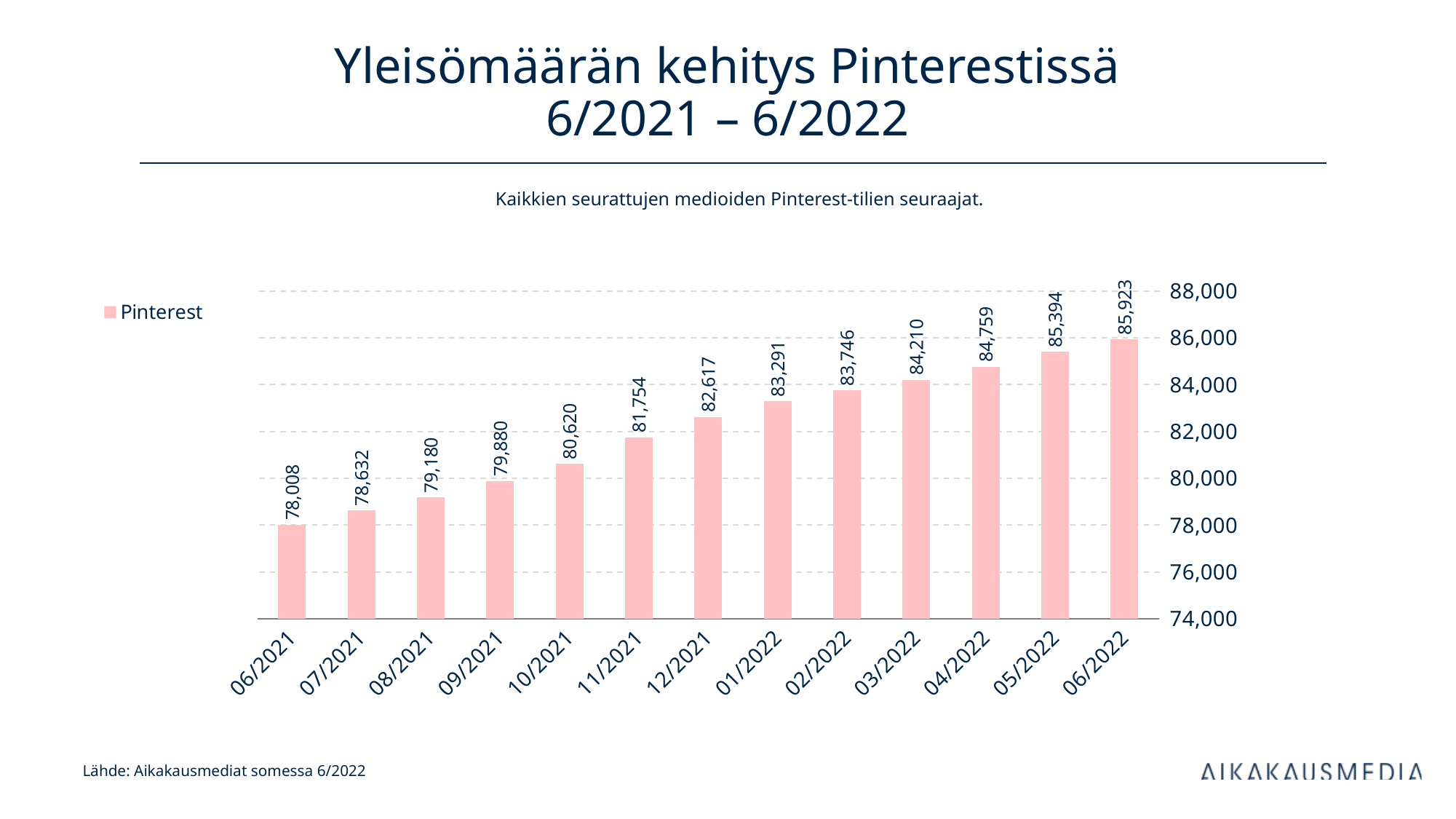
Do the values rise or fall from 06/2021 to 06/2022? rise What is the value for 03/2022? 84,210 How many series does the legend list? 1 Which month has the lowest value? 06/2021 Which is larger, the value for 10/2021 or the value for 01/2022? 01/2022 How many months are shown on the x axis? 13 What kind of chart is shown on the slide? bar chart What is the difference between the values for 06/2022 and 06/2021? 7,915 What is the value for 12/2021? 82,617 What is the value for 06/2021? 78,008 Which month has the highest value? 06/2022 Is the value for 11/2021 greater or less than 80,000? greater